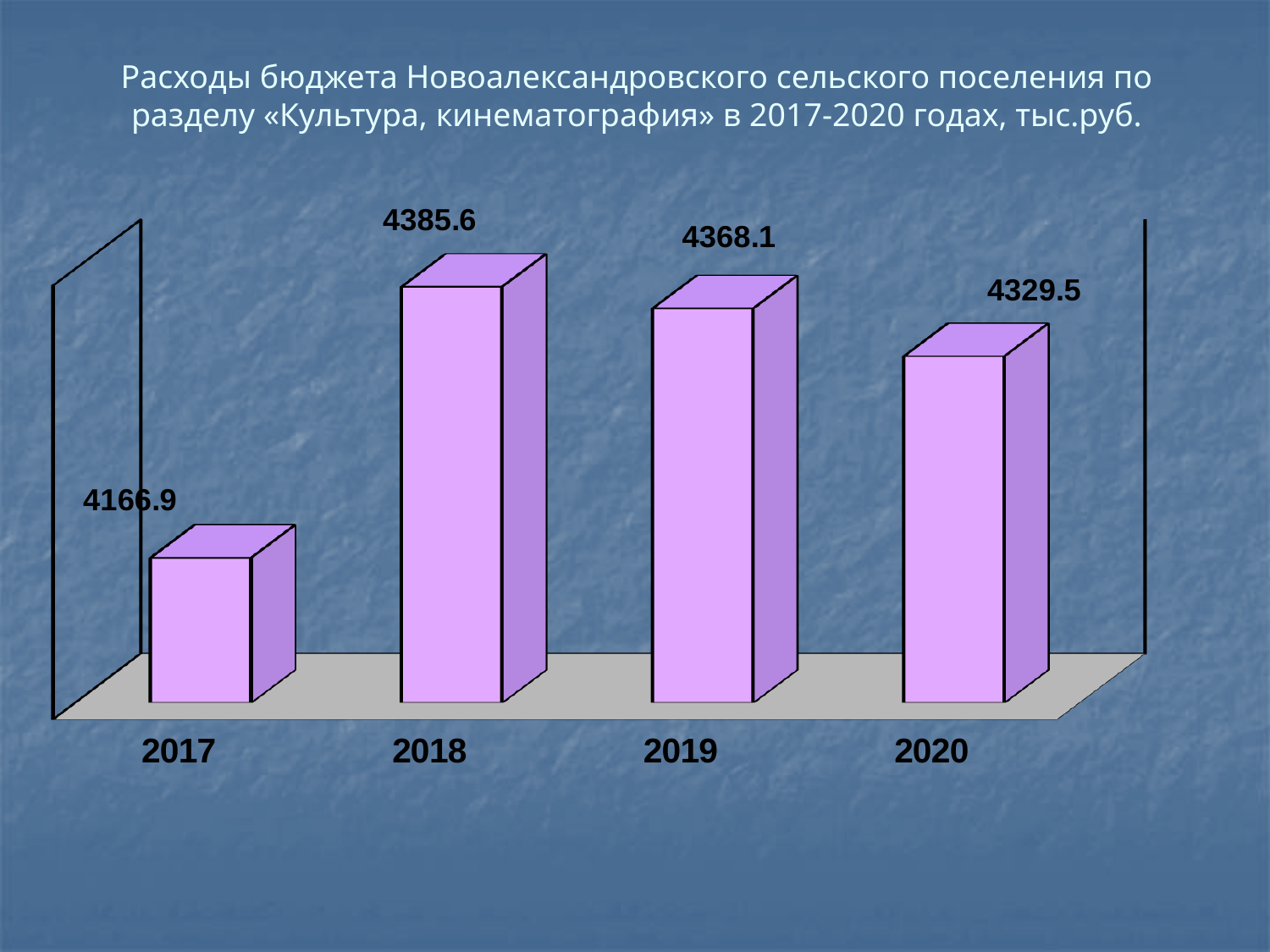
In what unit are the values on the chart expressed, according to the title? тыс.руб. What is the value for 2019? 4368.1 Which year has the highest value? 2018 What is the value for 2020? 4329.5 How many years are shown on the chart? 4 What is the difference between the values for 2019 and 2020? 38.6 What kind of chart is shown on the slide? bar chart Which year has the lowest value? 2017 Which is larger, the value for 2018 or the value for 2020? 2018 What is the value for 2018? 4385.6 What is the difference between the values for 2018 and 2017? 218.7 What is the value for 2017? 4166.9